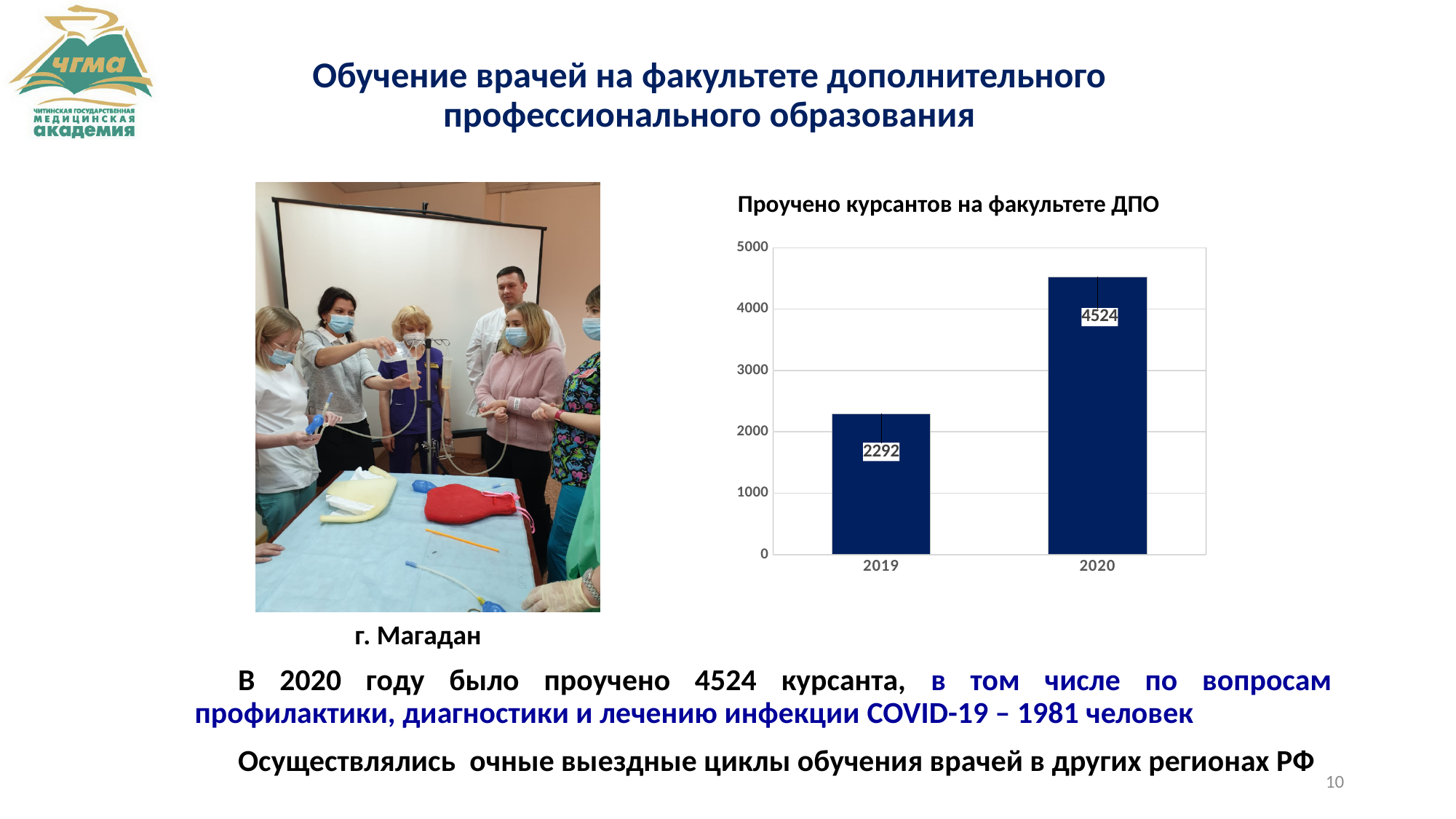
What is the difference between the values for 2020 and 2019? 2232 Which year has the lowest value in the chart? 2019 How many categories are shown on the x axis of the chart? 2 What kind of chart is shown on the slide? bar chart Do the values rise or fall from 2019 to 2020? rise Which year has the highest value in the chart? 2020 Is the value for 2020 greater or less than 4000? greater What is the value for 2019 in the chart? 2292 What is the title of the chart? Проучено курсантов на факультете ДПО Which is larger, the value for 2019 or the value for 2020? 2020 Is the value for 2019 greater or less than 3000? less What is the value for 2020 in the chart? 4524